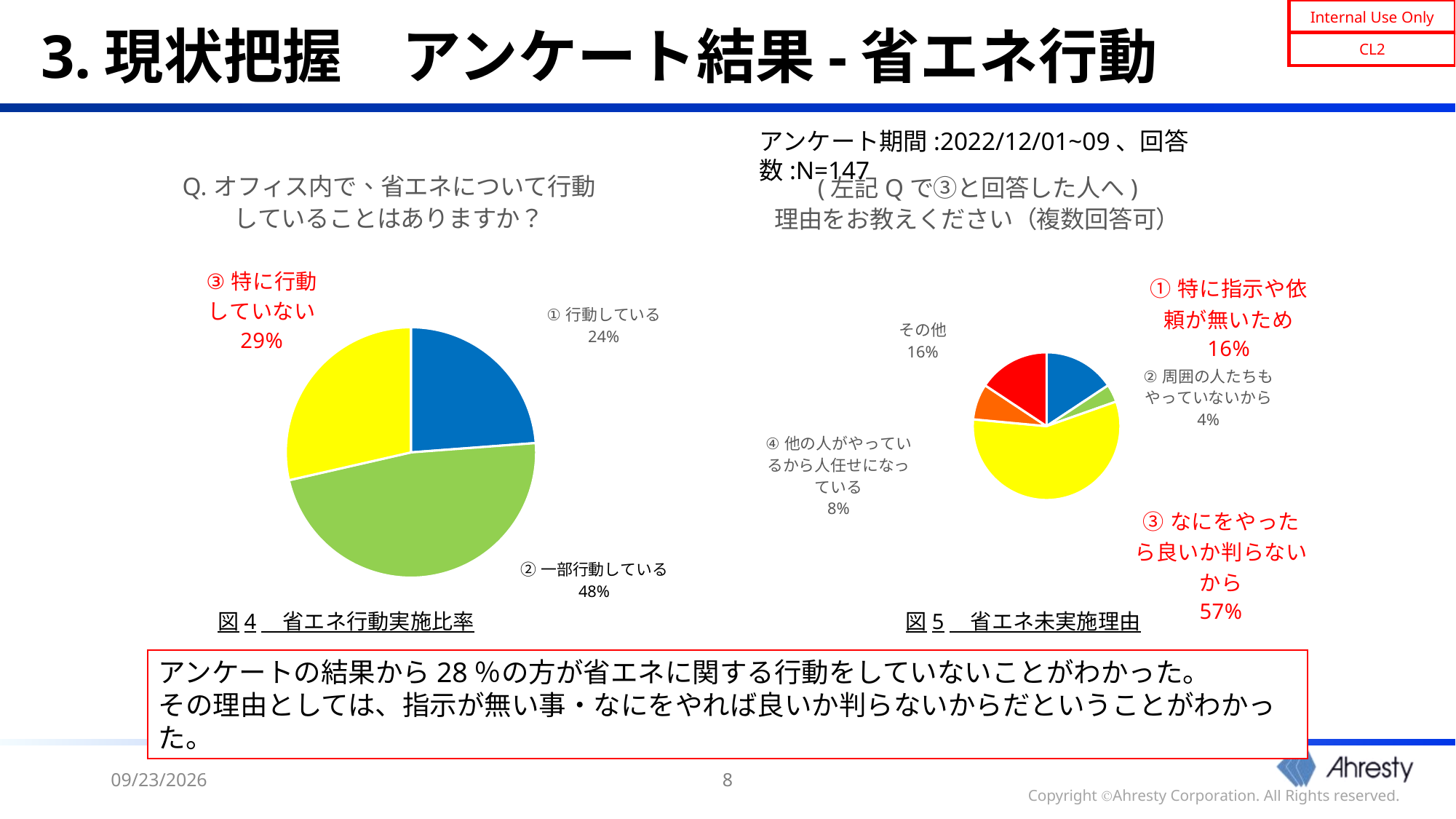
In the left chart (図4 省エネ行動実施比率), which category has the smallest share? ① 行動している In the right chart (図5 省エネ未実施理由), what percentage is shown for ③ なにをやったら良いか判らないから? 57% In the left chart (図4 省エネ行動実施比率), what is the difference in percentage points between ② 一部行動している and ① 行動している? 24 In the left chart (図4 省エネ行動実施比率), which category has the largest share? ② 一部行動している In the right chart (図5 省エネ未実施理由), what percentage is shown for ④ 他の人がやっているから人任せになっている? 8% In the left chart (図4 省エネ行動実施比率), how many categories are shown? 3 In the left chart (図4 省エネ行動実施比率), what percentage of respondents answered ③ 特に行動していない? 29% In the right chart (図5 省エネ未実施理由), which is larger: ① 特に指示や依頼が無いため or ④ 他の人がやっているから人任せになっている? ① 特に指示や依頼が無いため In the right chart (図5 省エネ未実施理由), how many categories are shown? 5 In the right chart (図5 省エネ未実施理由), which category has the smallest share? ② 周囲の人たちもやっていないから What type of chart is 図4 省エネ行動実施比率? Pie chart In the left chart (図4 省エネ行動実施比率), what percentage of respondents answered ② 一部行動している? 48%